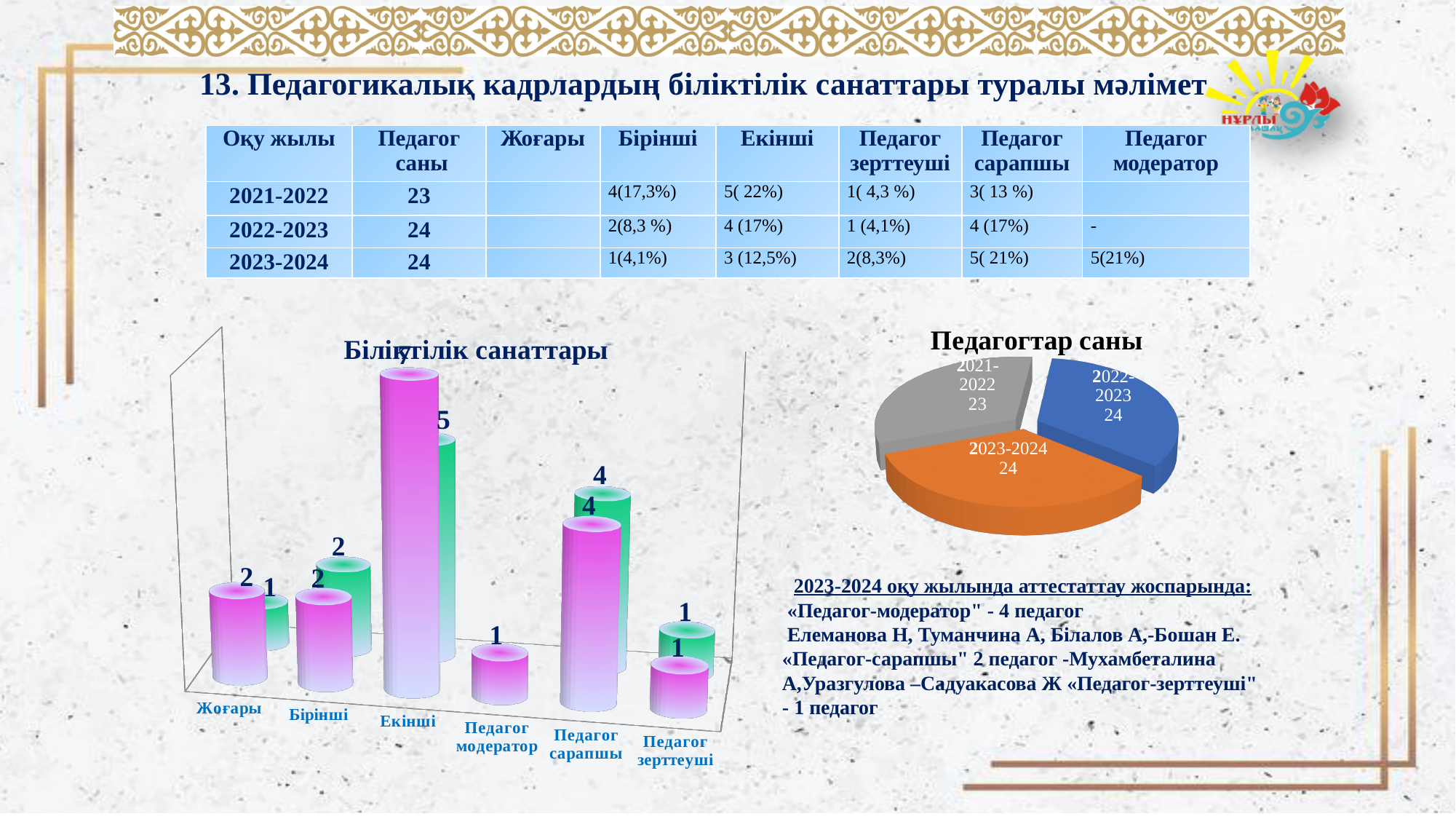
What kind of chart is the chart titled "Біліктілік санаттары"? bar chart In the "Біліктілік санаттары" bar chart, is the pink bar for Педагог сарапшы or the pink bar for Жоғары larger? Педагог сарапшы In the "Педагогтар саны" pie chart, what is the value for 2023-2024? 24 In the "Педагогтар саны" pie chart, what is the difference between the values for 2022-2023 and 2021-2022? 1 In the "Педагогтар саны" pie chart, which year has the smallest slice? 2021-2022 What kind of chart is the chart titled "Педагогтар саны"? pie chart How many slices does the "Педагогтар саны" pie chart have? 3 How many categories are shown on the x axis of the "Біліктілік санаттары" bar chart? 6 In the "Біліктілік санаттары" bar chart, which category has the tallest bar? Екінші In the "Біліктілік санаттары" bar chart, what is the value of the pink bar for Педагог сарапшы? 4 In the "Педагогтар саны" pie chart, what is the value for 2021-2022? 23 In the "Біліктілік санаттары" bar chart, what is the value of the bar for Педагог модератор? 1